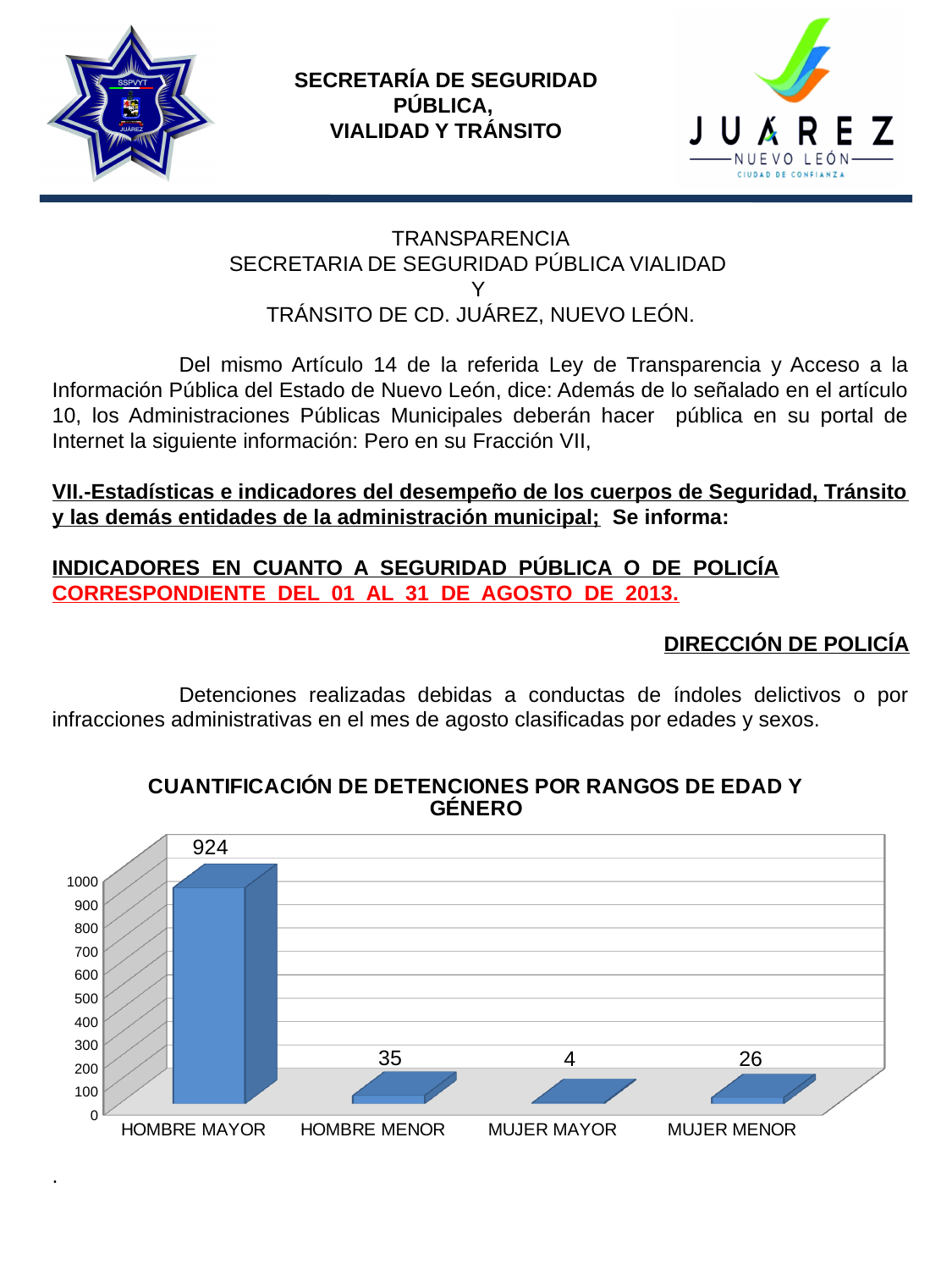
What is the difference between the values for HOMBRE MENOR and MUJER MENOR? 9 How many categories are shown on the x axis? 4 Which category has the highest value? HOMBRE MAYOR What is the value for MUJER MENOR? 26 What is the difference between the values for HOMBRE MAYOR and HOMBRE MENOR? 889 What is the value for HOMBRE MAYOR? 924 Which is larger, the value for HOMBRE MENOR or the value for MUJER MENOR? HOMBRE MENOR What is the value for MUJER MAYOR? 4 What kind of chart is shown on the slide? bar chart What is the title of the chart? CUANTIFICACIÓN DE DETENCIONES POR RANGOS DE EDAD Y GÉNERO Which category has the lowest value? MUJER MAYOR What is the value for HOMBRE MENOR? 35